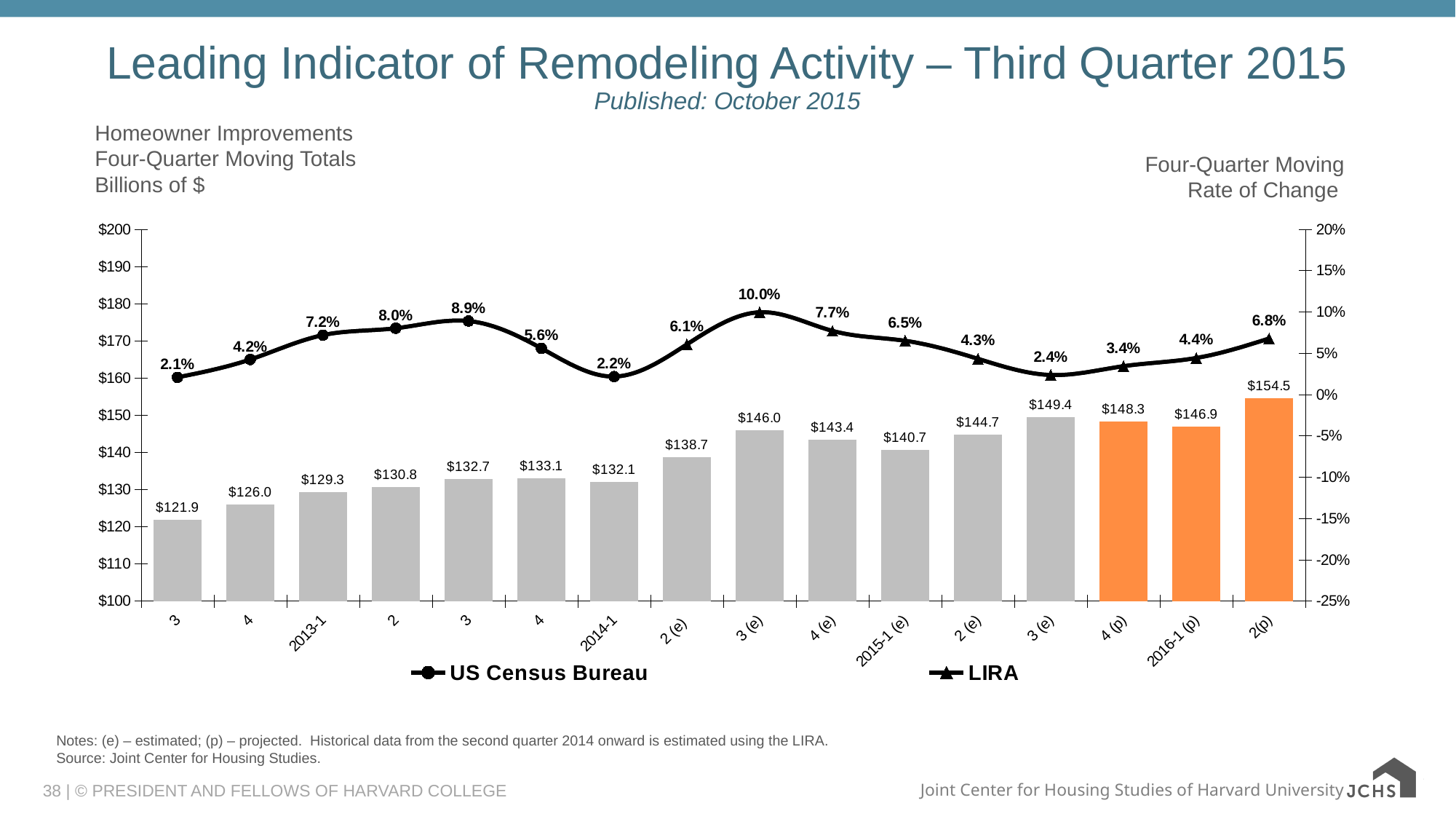
What is the four-quarter moving rate of change shown for 2014-1? 2.2% Which bar is taller, 3 (e) or 4 (e)? 3 (e) How many series does the legend list? 2 Which category has the highest bar? 2(p) How many bars are plotted on the chart? 16 What is the difference between the bar values for 2(p) and 2016-1 (p)? $7.6 What is the value of the leftmost bar (labeled 3)? $121.9 What is the highest rate of change shown on the line, and at which category? 10.0% at 3 (e) What kind of chart is this? Combination bar and line chart What is the four-quarter moving total for 2015-1 (e)? $140.7 Which series in the legend uses triangle markers? LIRA What is the lowest rate of change shown on the line? 2.1%